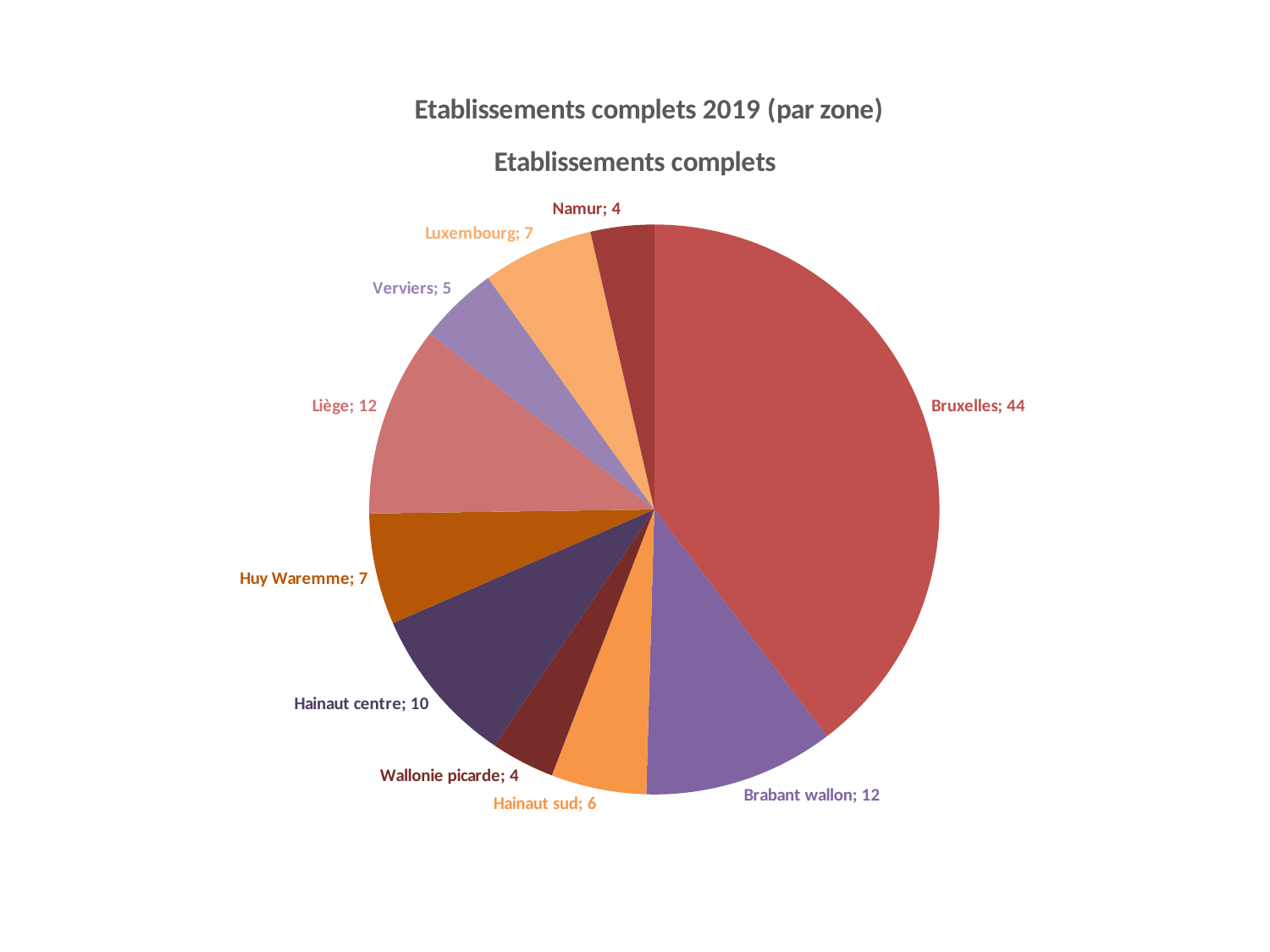
What is the value for Hainaut centre? 10 What is the value for Luxembourg? 7 Which zone has the largest slice of the pie? Bruxelles What is the difference between the values for Bruxelles and Brabant wallon? 32 What is the value for Verviers? 5 What is the value for Bruxelles? 44 What is the title of the chart? Etablissements complets How many zones (slices) are shown in the pie chart? 10 What kind of chart is shown on the slide? pie chart Which is larger, the value for Hainaut centre or the value for Huy Waremme? Hainaut centre Which is larger, the value for Liège or the value for Verviers? Liège What is the difference between the values for Hainaut centre and Hainaut sud? 4